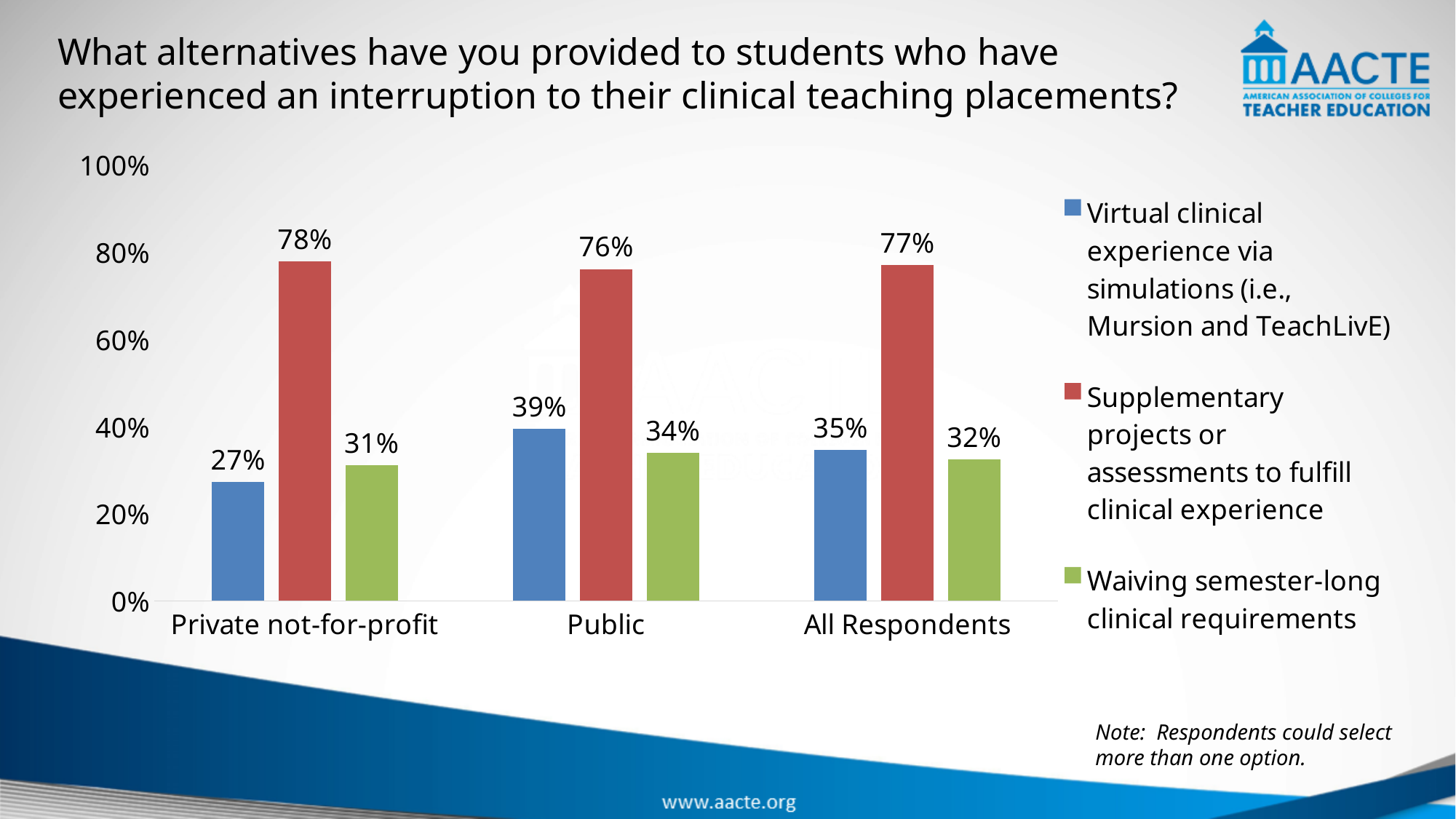
What percentage of Public respondents provided virtual clinical experience via simulations? 39% What is the difference between the Supplementary projects value for Private not-for-profit and for Public? 2% What kind of chart is shown on the slide? Bar chart What percentage of All Respondents reported waiving semester-long clinical requirements? 32% Which category has the lowest value for Waiving semester-long clinical requirements? Private not-for-profit Is the value for Supplementary projects among All Respondents greater or less than 60%? greater How many series does the legend list? 3 For Private not-for-profit, which is larger: Virtual clinical experience via simulations or Waiving semester-long clinical requirements? Waiving semester-long clinical requirements What is the value for Supplementary projects or assessments to fulfill clinical experience among Private not-for-profit respondents? 78% What colour represents Waiving semester-long clinical requirements in the chart? Green Which category has the highest value for Virtual clinical experience via simulations? Public How many categories are shown on the x axis? 3